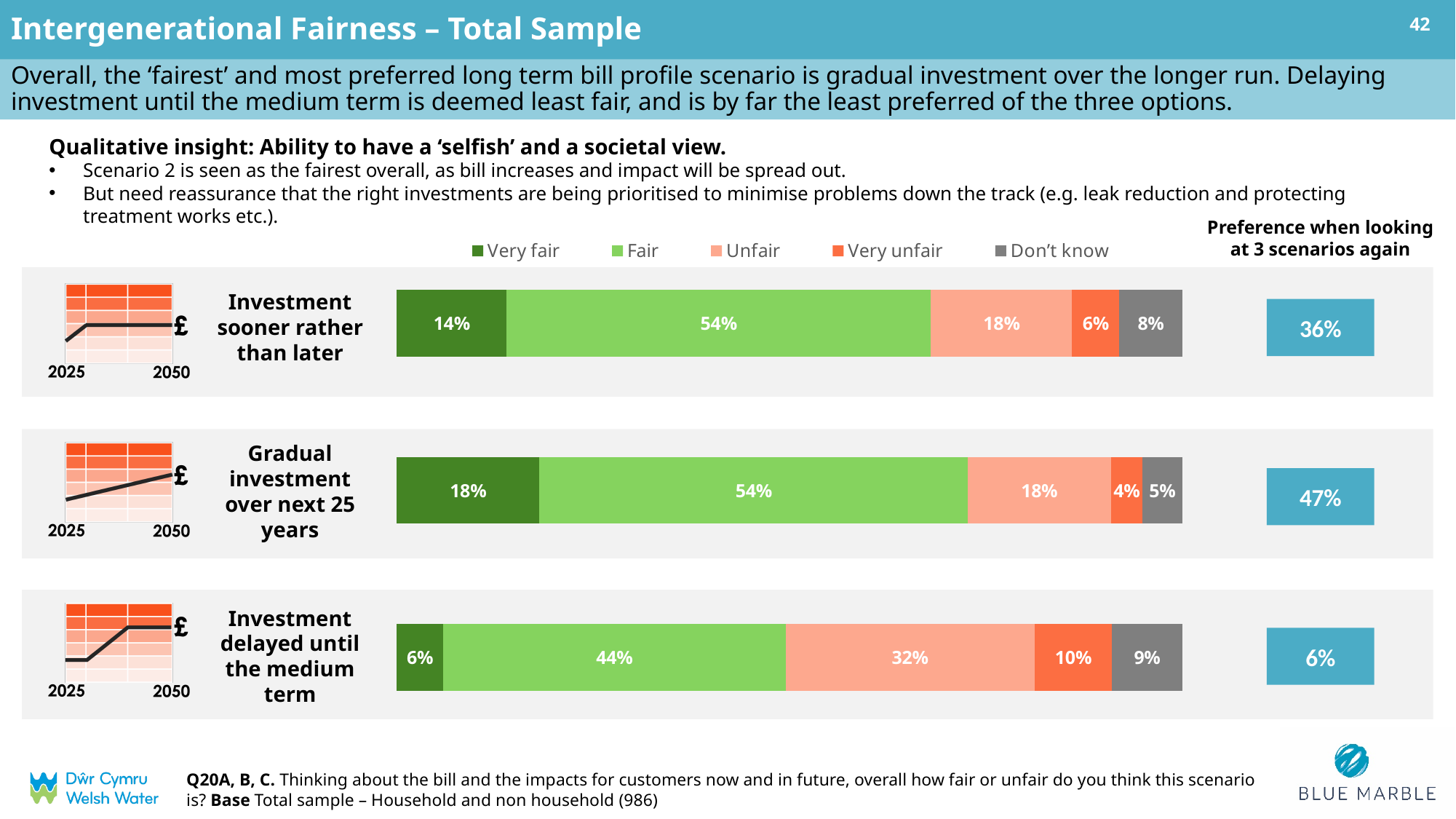
How many series does the legend list? 5 What is the difference between the 'Fair' percentage for 'Investment sooner rather than later' and for 'Investment delayed until the medium term'? 10 percentage points What percentage of respondents rated 'Investment delayed until the medium term' as Unfair? 32% Which is larger: the 'Unfair' percentage for 'Investment delayed until the medium term' or for 'Gradual investment over next 25 years'? Investment delayed until the medium term What is the combined 'Very fair' and 'Fair' percentage for 'Gradual investment over next 25 years'? 72% Which scenario has the highest 'Very unfair' percentage? Investment delayed until the medium term Which scenario has the lowest 'Very fair' percentage? Investment delayed until the medium term What percentage of respondents rated 'Gradual investment over next 25 years' as Very fair? 18% What kind of chart is used to show the fairness ratings? Stacked bar chart How many scenarios are shown in the stacked bar chart? 3 What is the 'Don't know' percentage for 'Investment sooner rather than later'? 8% In the 'Preference when looking at 3 scenarios again' column, which scenario has the highest preference and what is its value? Gradual investment over next 25 years, 47%